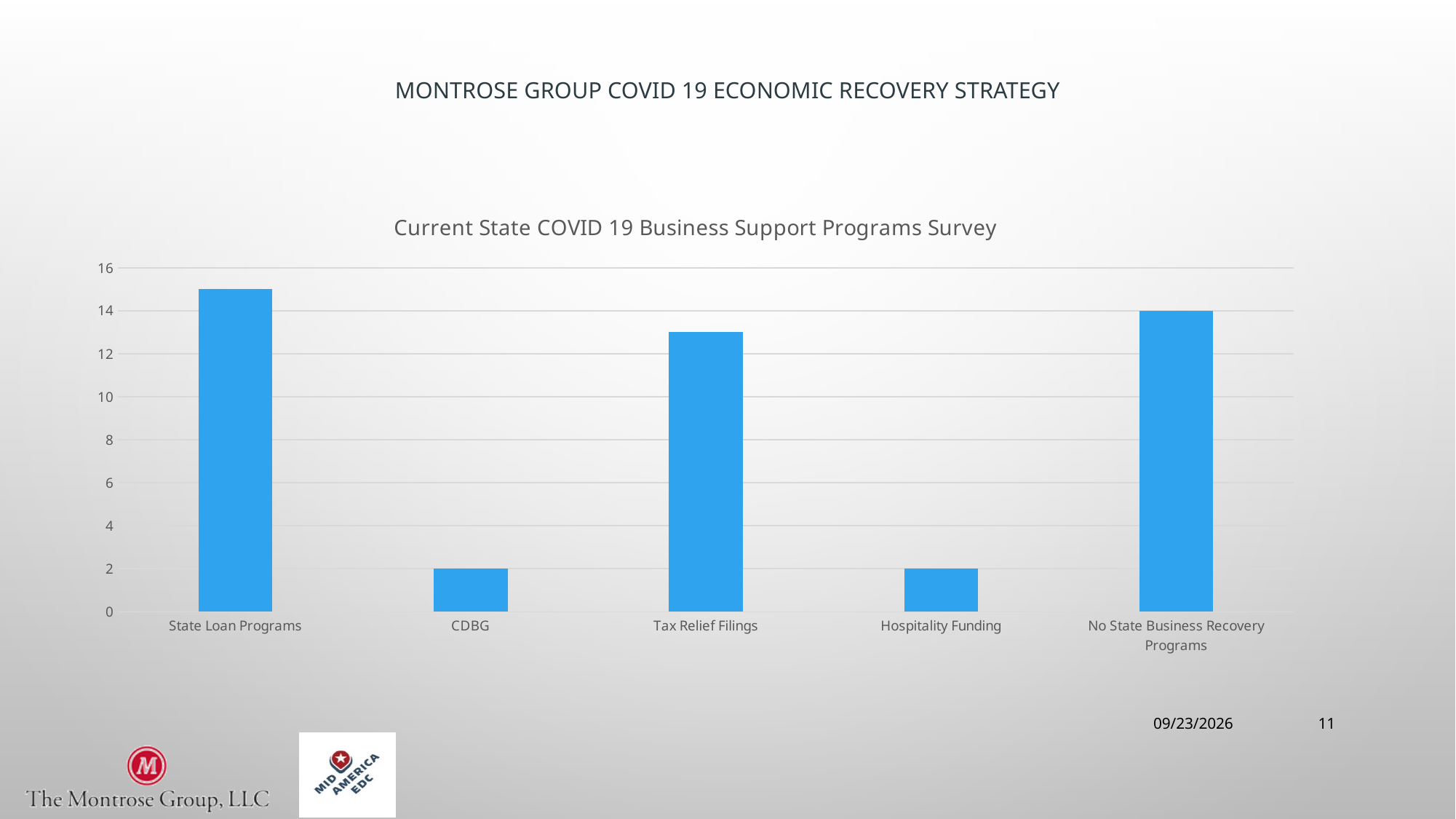
What is the value for Hospitality Funding? 2 Which category has the highest value? State Loan Programs How many categories are shown on the x axis of the chart? 5 What is the value for No State Business Recovery Programs? 14 What colour are the bars in the chart? Blue What is the difference between the value for No State Business Recovery Programs and the value for CDBG? 12 Is the value for Tax Relief Filings greater or less than 12? greater What is the value for CDBG? 2 What is the title of the chart? Current State COVID 19 Business Support Programs Survey What kind of chart is shown on the slide? Bar chart Which is larger, the value for State Loan Programs or the value for CDBG? State Loan Programs Is the value for State Loan Programs greater or less than 14? greater